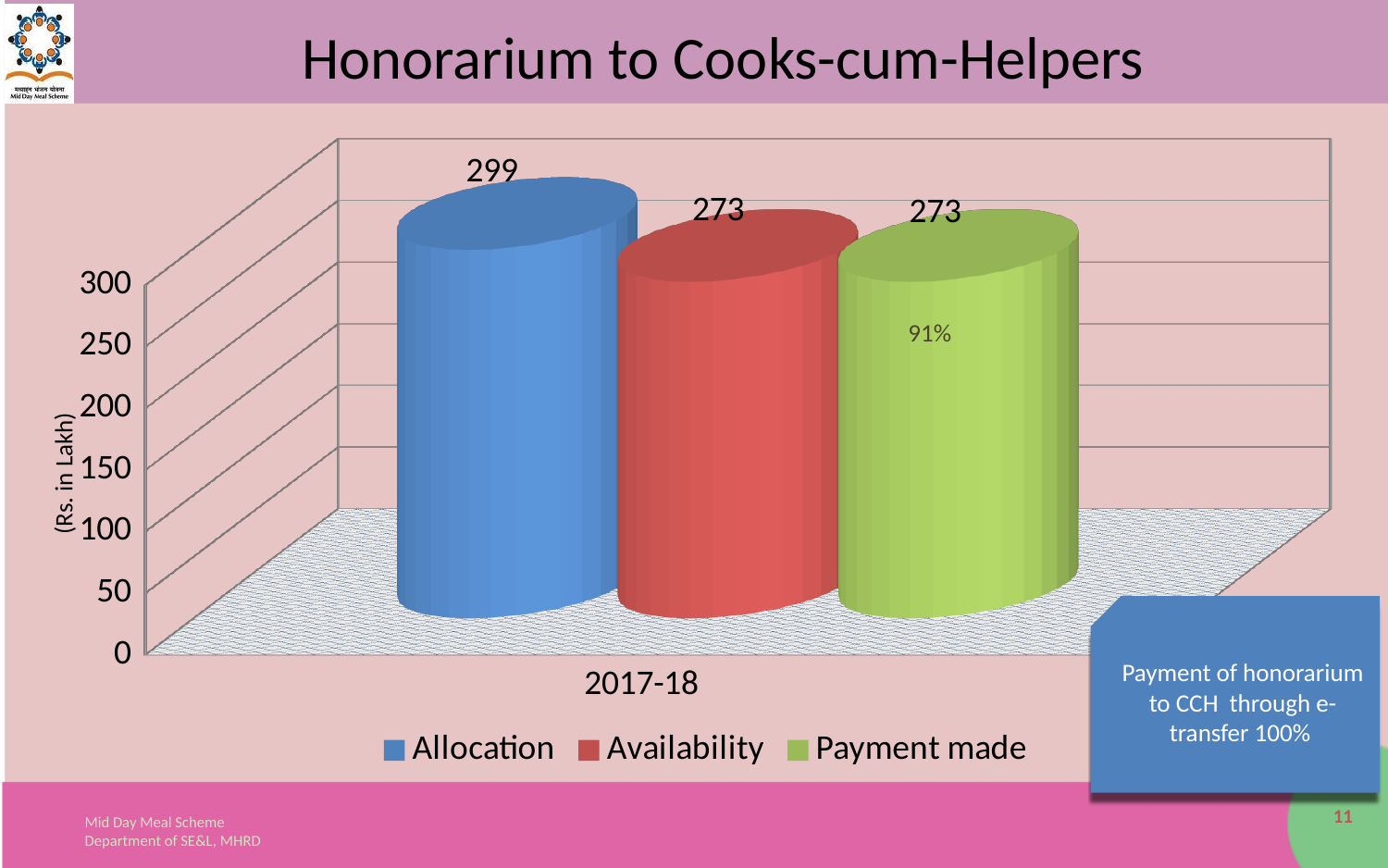
Which series has the highest value in 2017-18? Allocation What is the value for Availability in 2017-18? 273 Which is larger, Allocation or Payment made? Allocation Is the value for Availability greater or less than 250? greater How many categories are shown on the x axis? 1 What is the difference between Allocation and Availability in 2017-18? 26 What is the value for Payment made in 2017-18? 273 What unit is shown on the y axis label? Rs. in Lakh What is the value for Allocation in 2017-18? 299 How many series does the legend list? 3 What percentage label is printed on the Payment made bar? 91% What kind of chart is shown on the slide? bar chart